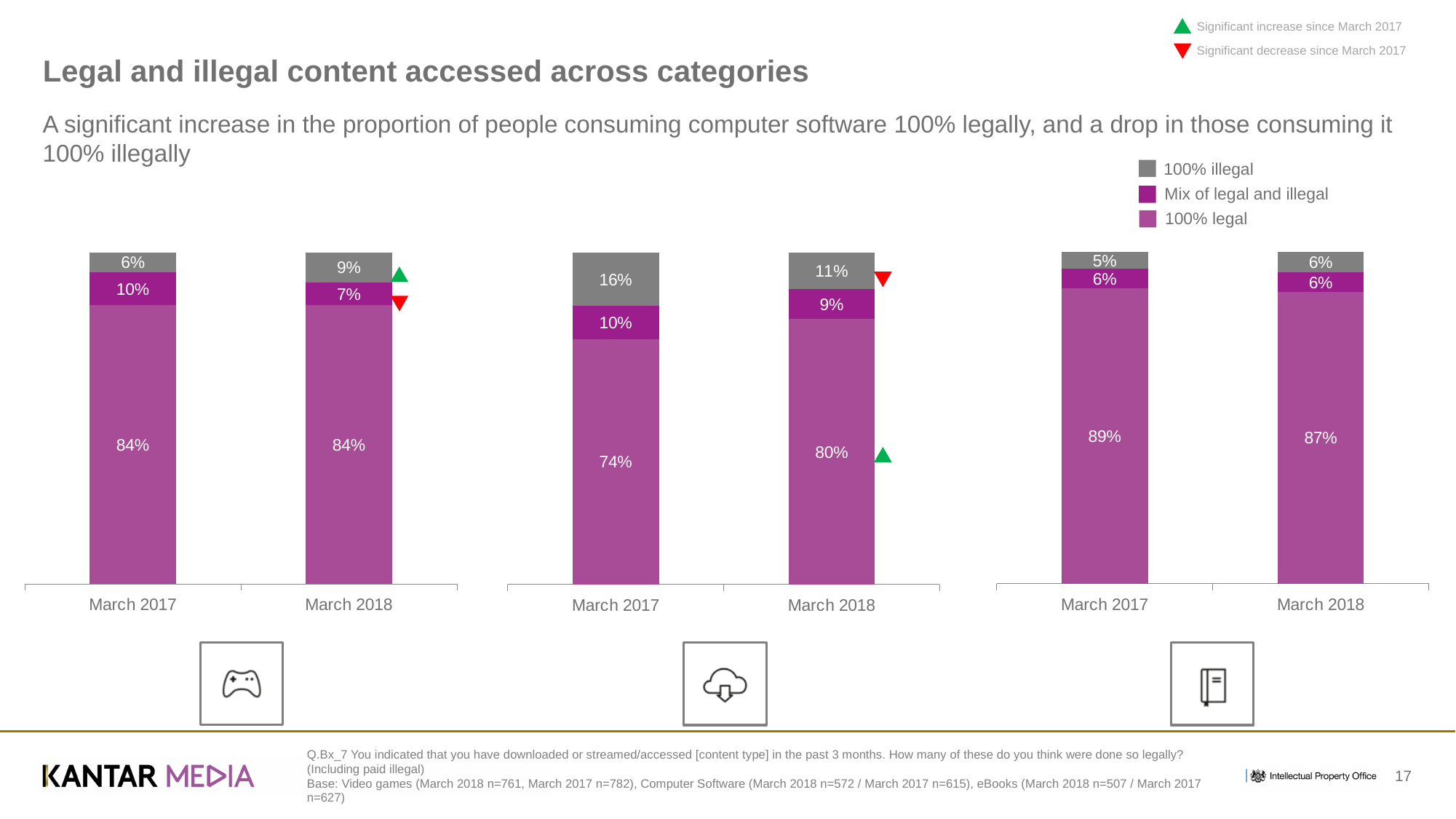
In the middle chart, what is the value for Mix of legal and illegal in March 2018? 9% In the left-hand chart, what is the value for 100% legal in March 2018? 84% What kind of chart is the left-hand chart? stacked bar chart In the right-hand chart, does the 100% legal value rise or fall from March 2017 to March 2018? fall In the middle chart, what is the value for 100% illegal in March 2017? 16% In the middle chart, what is the difference between the 100% legal values for March 2018 and March 2017? 6% In the left-hand chart, what is the difference between the 100% illegal values for March 2018 and March 2017? 3% How many series does the legend list? 3 In the middle chart, does the 100% legal value rise or fall from March 2017 to March 2018? rise In the right-hand chart, what is the total of the March 2018 stacked bar? 99% In the right-hand chart, what is the value for 100% legal in March 2017? 89% In the middle chart, which is larger, the 100% illegal value for March 2017 or for March 2018? March 2017